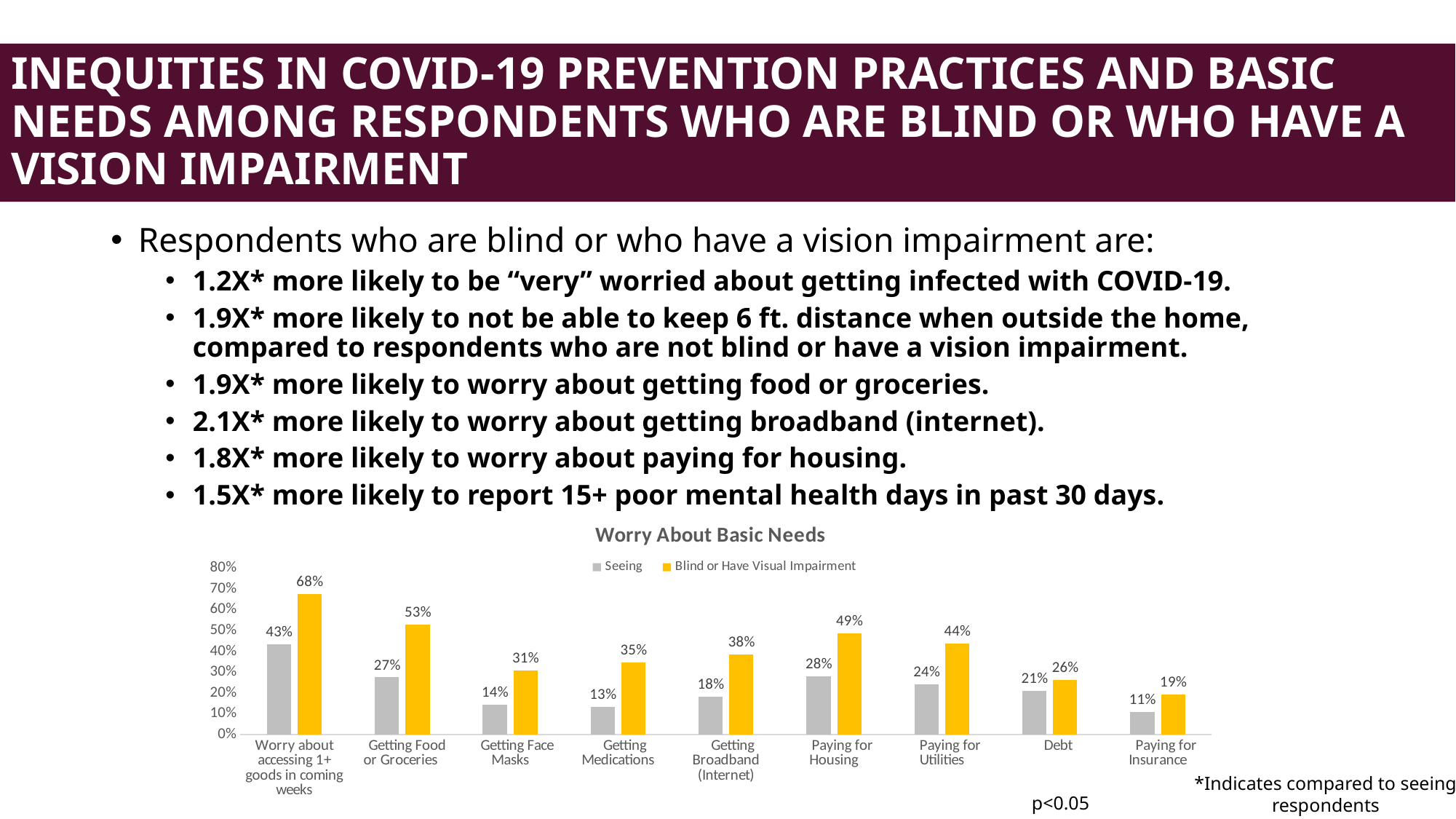
Which is larger for Debt: the Seeing value or the Blind or Have Visual Impairment value? Blind or Have Visual Impairment How many series does the legend list? 2 What is the title of the chart? Worry About Basic Needs How many categories are shown on the x axis? 9 What is the value for Seeing for Paying for Housing? 28% Which category has the highest value for Blind or Have Visual Impairment? Worry about accessing 1+ goods in coming weeks What is the value for Blind or Have Visual Impairment for Getting Food or Groceries? 53% Which category has the lowest value for Seeing? Paying for Insurance What is the value for Seeing for Getting Medications? 13% Is the Blind or Have Visual Impairment value for Paying for Utilities greater or less than 40%? greater What is the difference between the Blind or Have Visual Impairment and Seeing values for Getting Broadband (Internet)? 20% What kind of chart is shown on the slide? bar chart